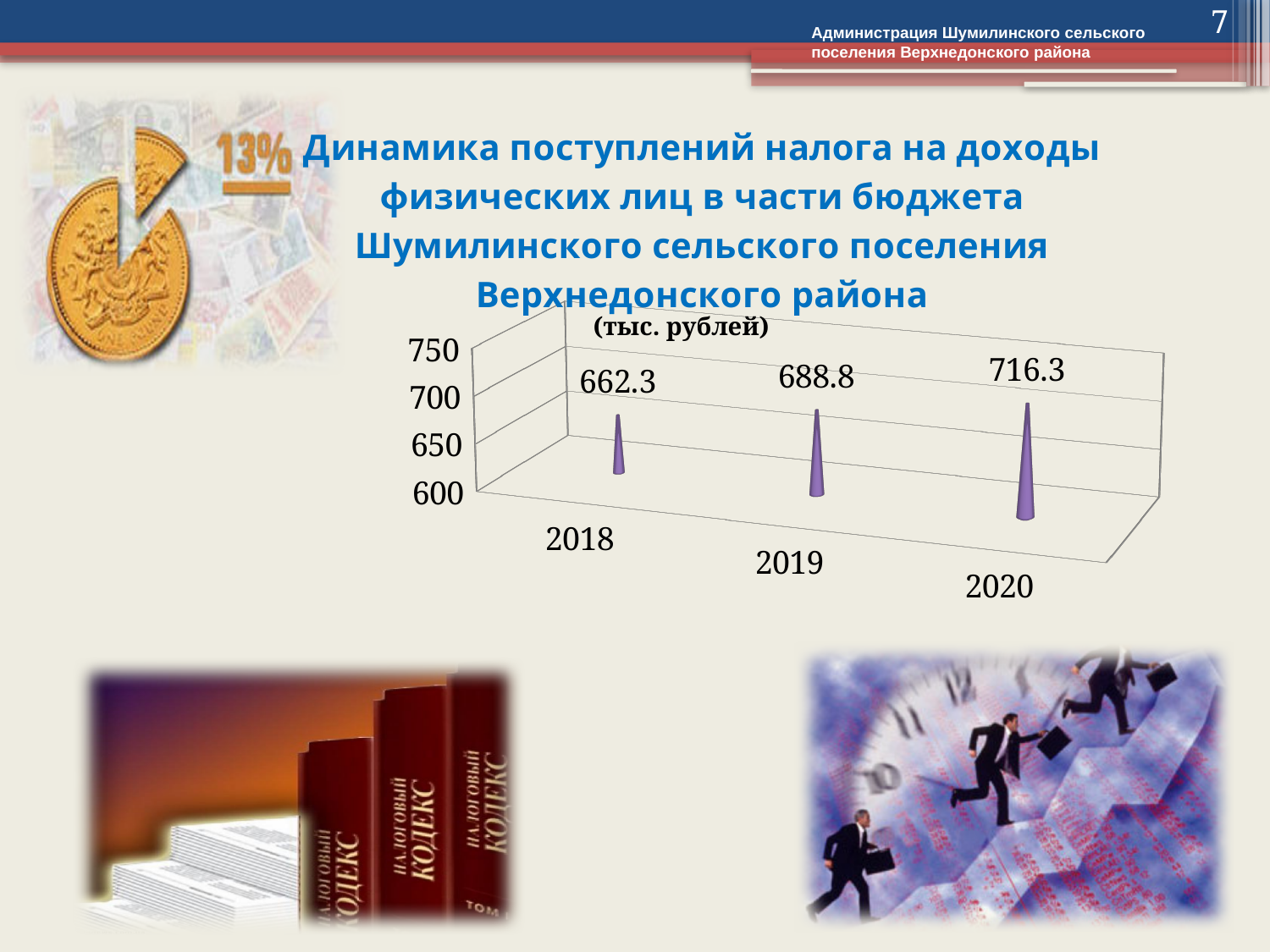
What is the difference between the values for 2020 and 2018? 54 What is the difference between the values for 2019 and 2018? 26.5 Which year has the lowest value? 2018 What is the value for 2018? 662.3 In what units are the chart values given, according to the label above the chart? тыс. рублей Do the values rise or fall from 2018 to 2020? rise What is the value for 2019? 688.8 Is the value for 2018 greater or less than 700? less What is the value for 2020? 716.3 Which year has the highest value? 2020 How many years are shown on the chart? 3 Which is larger, the value for 2019 or the value for 2020? 2020